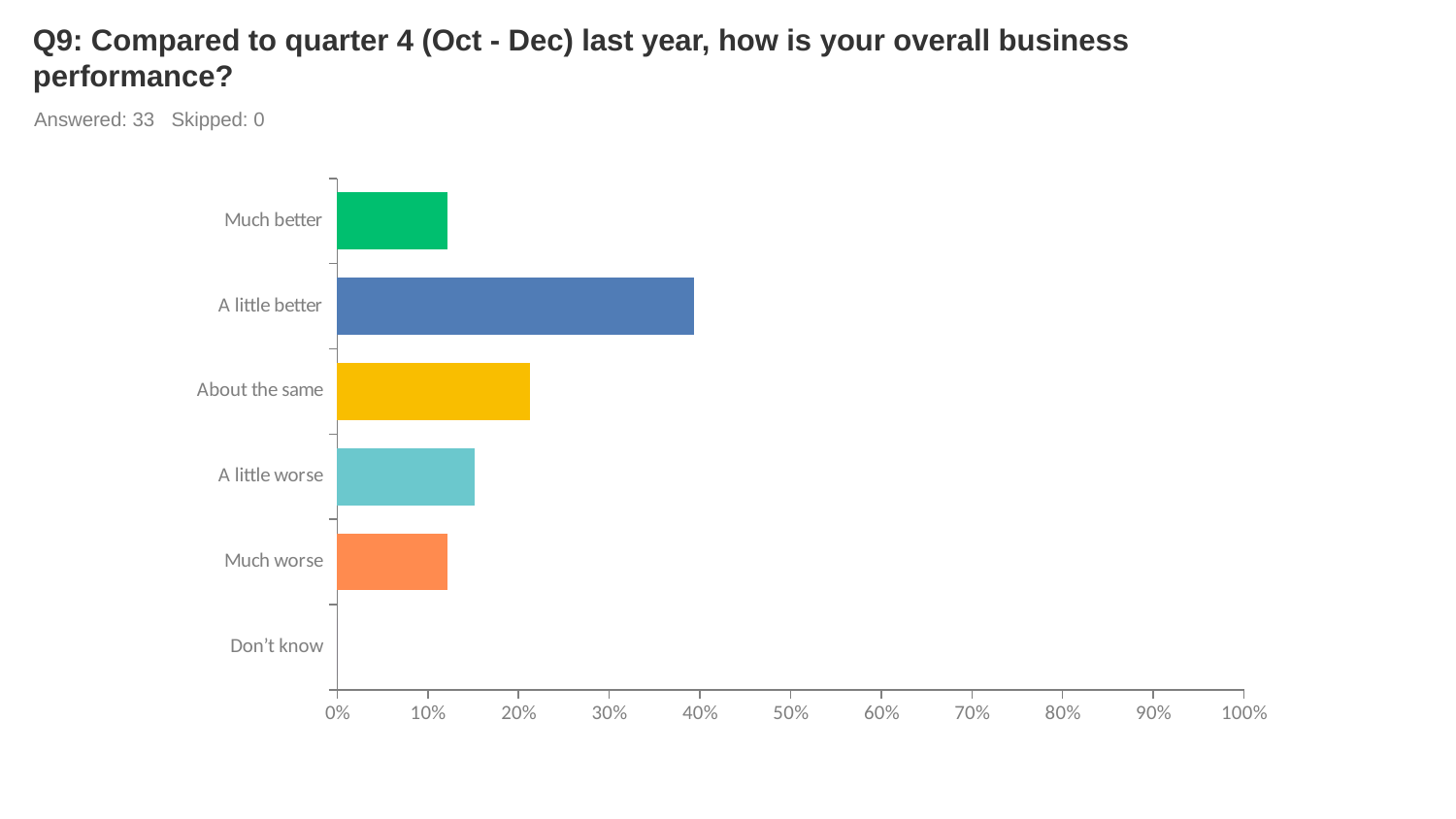
Is the value for A little better greater or less than 30%? greater Which is larger, the value for About the same or the value for A little worse? About the same What kind of chart is shown on the slide? bar chart Which is larger, the value for A little better or the value for About the same? A little better Which category has the lowest value? Don't know Is the value for Much better greater or less than 10%? greater Is the value for A little worse greater or less than 20%? less Which category has the highest value? A little better How many respondents answered the question shown on the slide? 33 How many categories are shown on the chart? 6 What is the value for Don't know? 0%